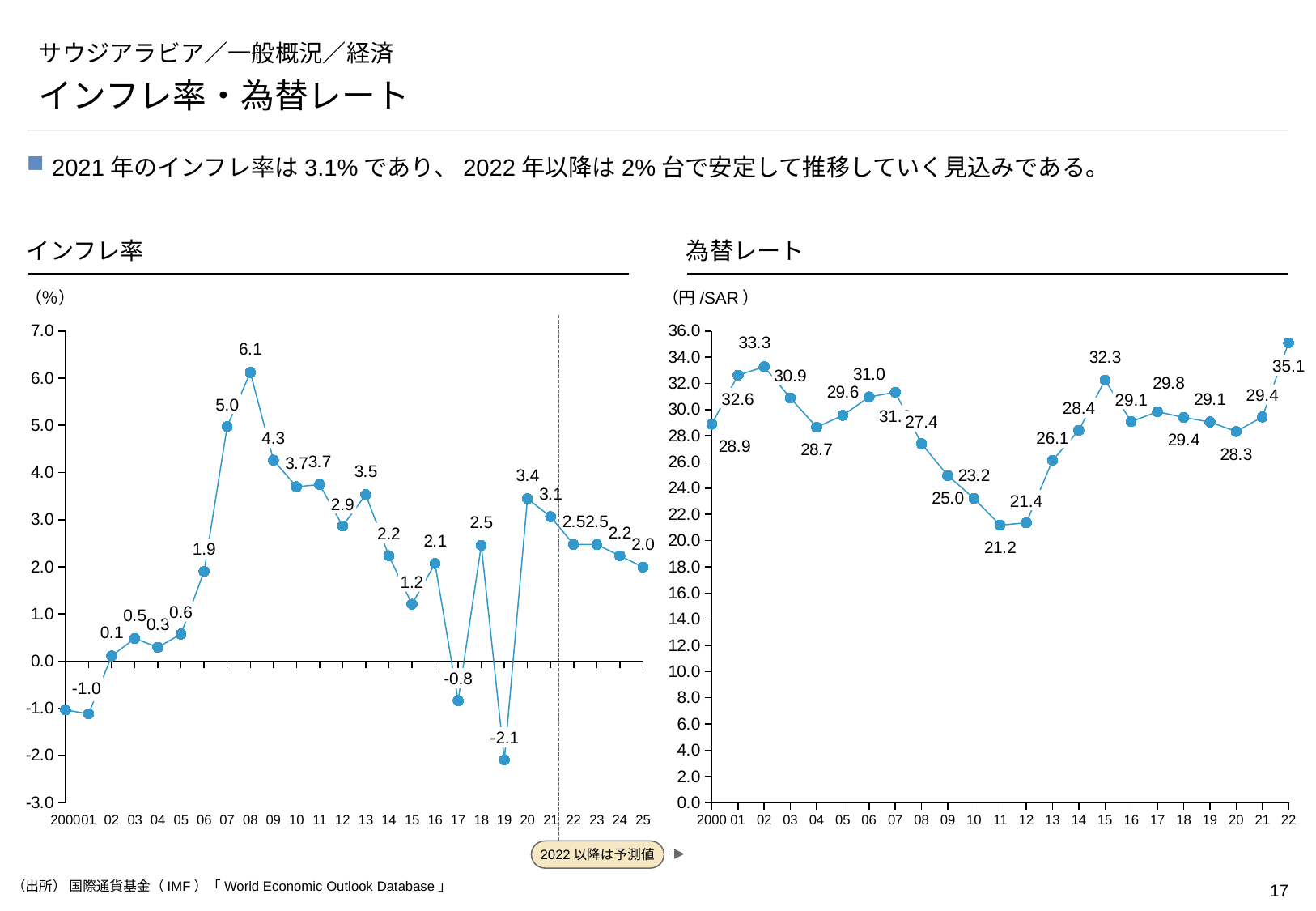
On the インフレ率 chart, which is larger, the value for 2007 or the value for 2009? 2007 On the 為替レート chart, which year has the highest value? 2022 On the インフレ率 chart, do the values rise or fall from 2022 to 2025? fall On the インフレ率 chart, which year has the highest value? 2008 On the インフレ率 chart, what is the difference between the 2008 value and the 2007 value? 1.1 On the インフレ率 chart, what is the value for 2021? 3.1 On the 為替レート chart, what is the value for 2002? 33.3 On the 為替レート chart, what is the value for 2011? 21.2 On the インフレ率 chart, which year has the lowest value? 2019 On the 為替レート chart, what is the difference between the 2022 value and the 2011 value? 13.9 On the インフレ率 chart, what is the inflation rate value for 2008? 6.1 What kind of chart is the 為替レート chart? line chart